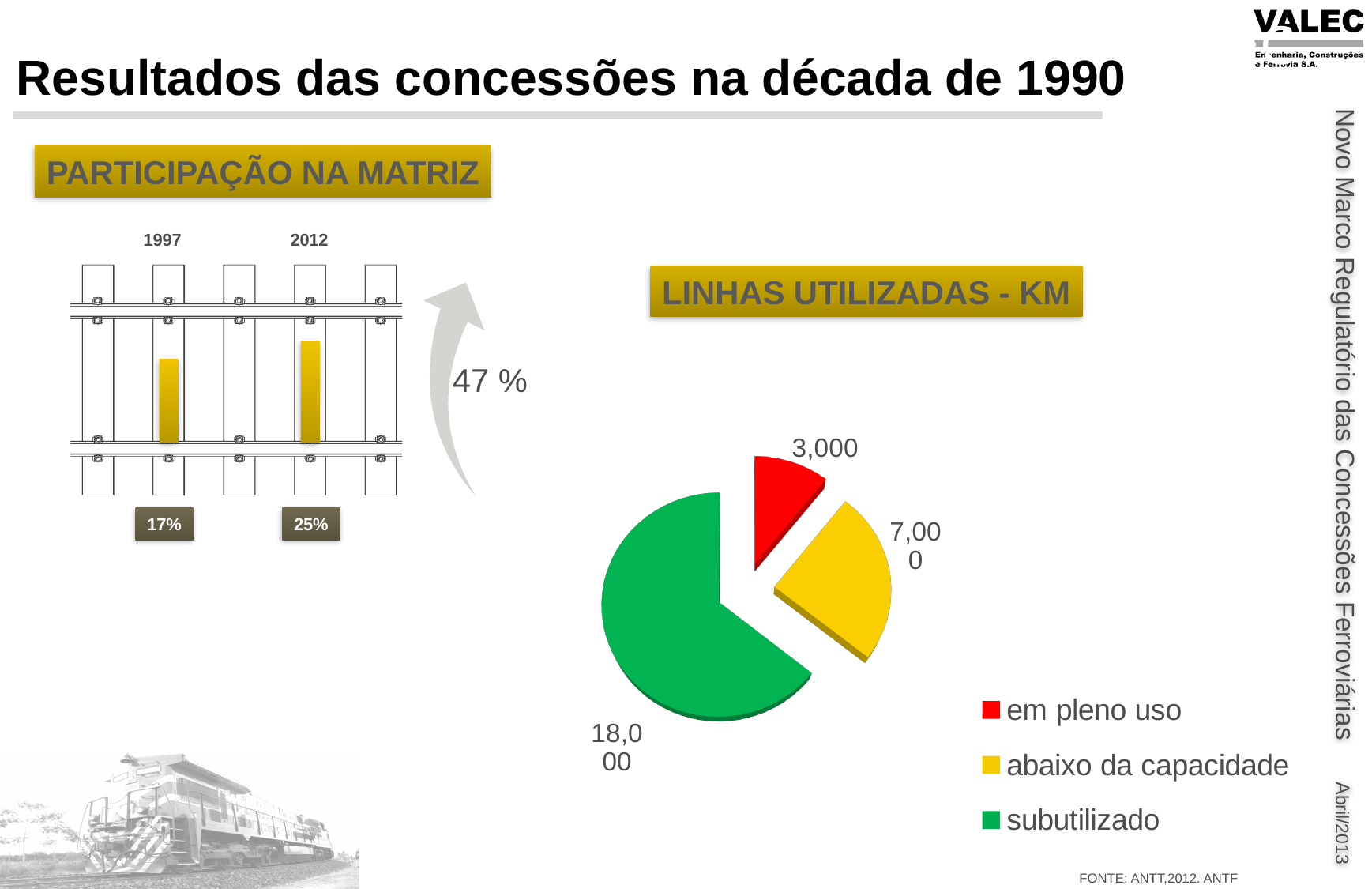
In the 'LINHAS UTILIZADAS - KM' pie chart, what is the value for 'abaixo da capacidade'? 7,000 In the 'LINHAS UTILIZADAS - KM' pie chart, what is the value for 'em pleno uso'? 3,000 In the 'LINHAS UTILIZADAS - KM' pie chart, which category has the smallest value? em pleno uso In the 'LINHAS UTILIZADAS - KM' pie chart, what is the difference between 'subutilizado' and 'abaixo da capacidade'? 11,000 What kind of chart is 'LINHAS UTILIZADAS - KM'? pie chart In the 'LINHAS UTILIZADAS - KM' pie chart, what is the total of all three slices? 28,000 In the 'PARTICIPAÇÃO NA MATRIZ' bar chart, what is the value for 2012? 25% In the 'LINHAS UTILIZADAS - KM' pie chart, what share of the total does 'abaixo da capacidade' represent? 25% In the 'PARTICIPAÇÃO NA MATRIZ' bar chart, what is the difference between the 2012 and 1997 values? 8% In the 'LINHAS UTILIZADAS - KM' pie chart, what is the value for 'subutilizado'? 18,000 How many entries does the legend of the 'LINHAS UTILIZADAS - KM' chart list? 3 In the 'LINHAS UTILIZADAS - KM' pie chart, which category has the largest value? subutilizado